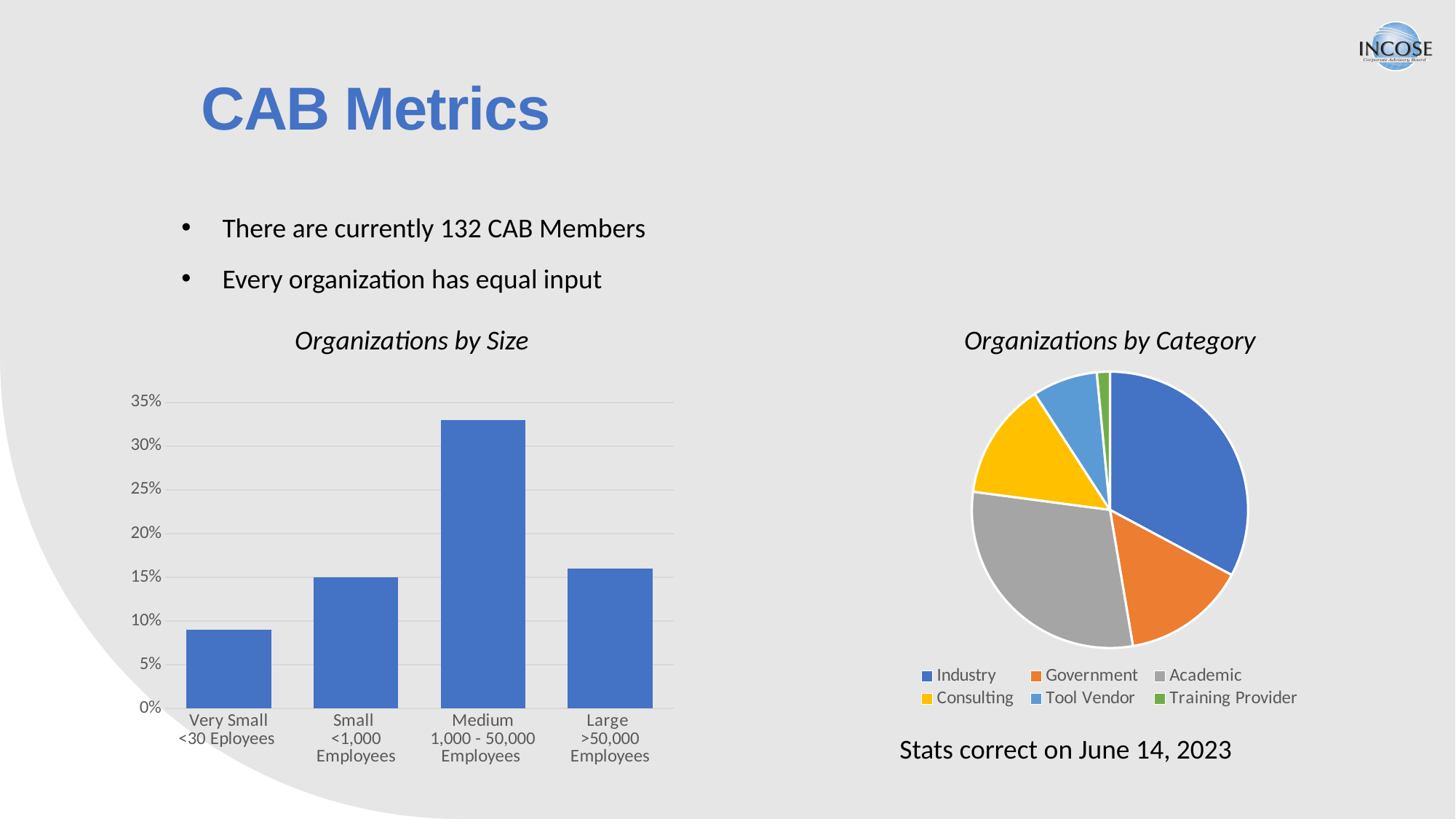
In the Organizations by Size chart, which is larger, the value for Very Small or the value for Large? Large In the Organizations by Category chart, which is larger, the Academic slice or the Consulting slice? Academic In the Organizations by Category chart, which category has the smallest slice? Training Provider In the Organizations by Size chart, is the value for Very Small greater or less than 10%? less In the Organizations by Size chart, is the value for Medium greater or less than 30%? greater What kind of chart is the Organizations by Size chart? bar chart In the Organizations by Size chart, is the value for Large greater or less than 20%? less In the Organizations by Category chart, which category has the largest slice? Industry How many categories are shown in the Organizations by Size chart? 4 How many categories does the legend of the Organizations by Category chart list? 6 In the Organizations by Size chart, which category has the lowest value? Very Small <30 Eployees In the Organizations by Size chart, which category has the highest value? Medium 1,000 - 50,000 Employees